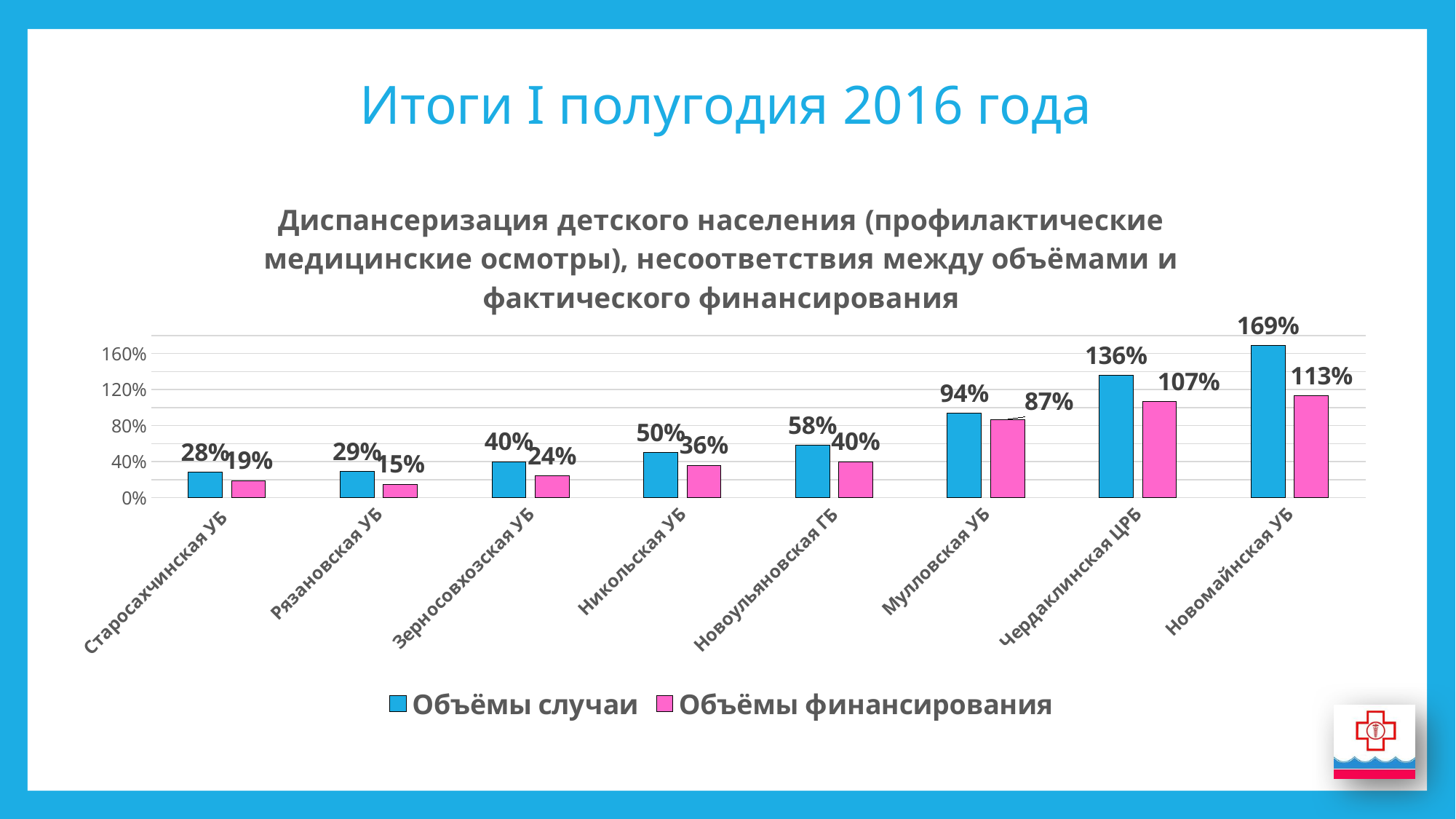
How many series does the legend list? 2 What kind of chart is shown on the slide? bar chart Is the value of Объёмы случаи for Чердаклинская ЦРБ greater or less than 120%? greater What is the value of Объёмы случаи for Новомайнская УБ? 169% Which category has the lowest value for Объёмы финансирования? Рязановская УБ Which colour represents Объёмы финансирования in the chart? pink What is the value of Объёмы финансирования for Рязановская УБ? 15% How many categories are shown on the x axis? 8 Which is larger for Мулловская УБ: Объёмы случаи or Объёмы финансирования? Объёмы случаи What is the value of Объёмы финансирования for Чердаклинская ЦРБ? 107% Which category has the highest value for Объёмы случаи? Новомайнская УБ What is the difference between Объёмы случаи and Объёмы финансирования for Новомайнская УБ? 56%